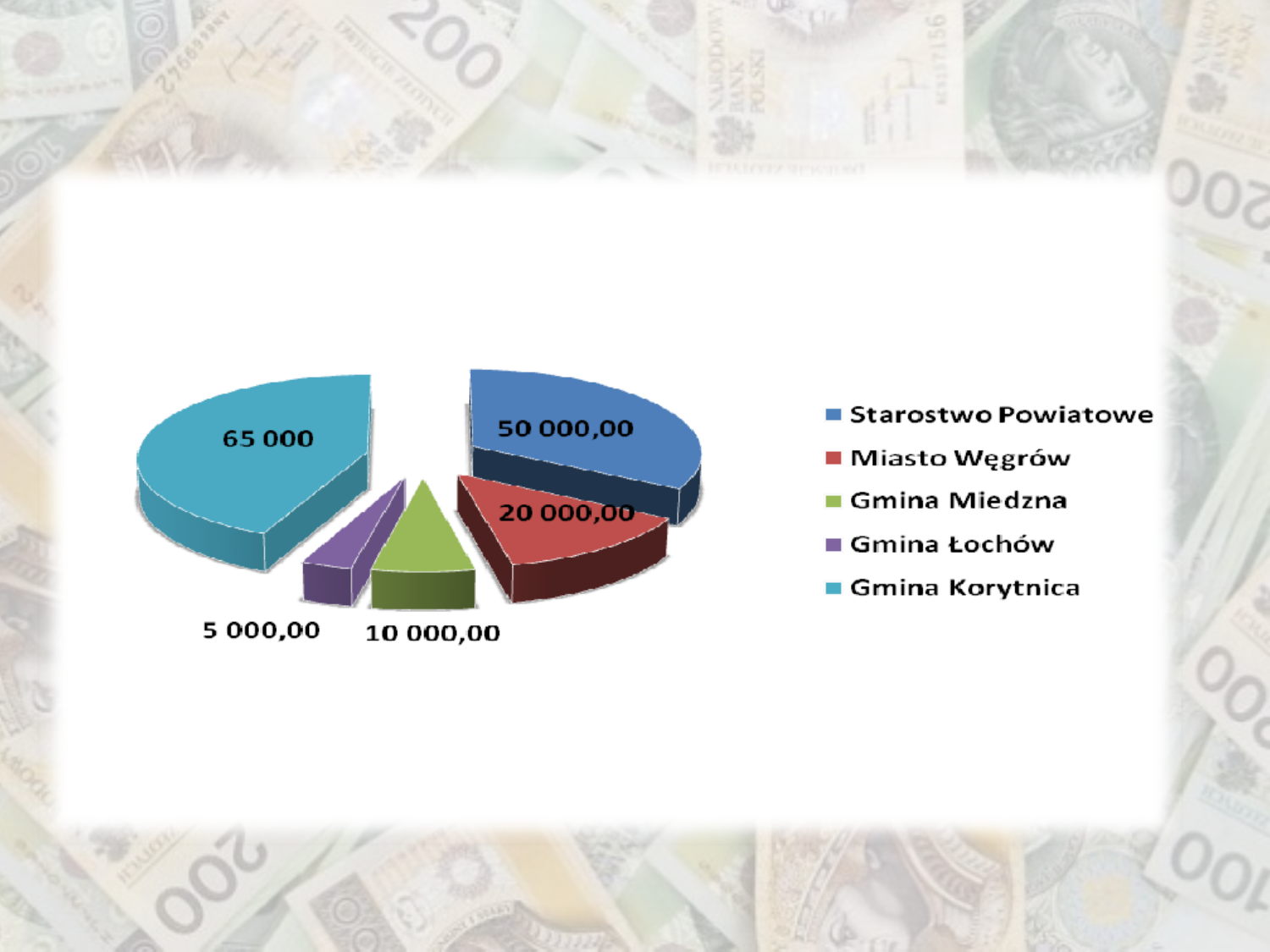
What is the value for Gmina Miedzna? 10 000,00 What is the value for Gmina Łochów? 5 000,00 Which is larger, the value for Miasto Węgrów or the value for Gmina Miedzna? Miasto Węgrów How many slices does the pie chart have? 5 What is the value for Miasto Węgrów? 20 000,00 What is the difference between the values for Gmina Korytnica and Starostwo Powiatowe? 15 000 Which category has the smallest slice of the pie? Gmina Łochów Which colour represents Gmina Korytnica in the legend? teal (light blue) What kind of chart is shown on the slide? pie chart Which category has the largest slice of the pie? Gmina Korytnica What is the value for Starostwo Powiatowe? 50 000,00 What is the value for Gmina Korytnica? 65 000